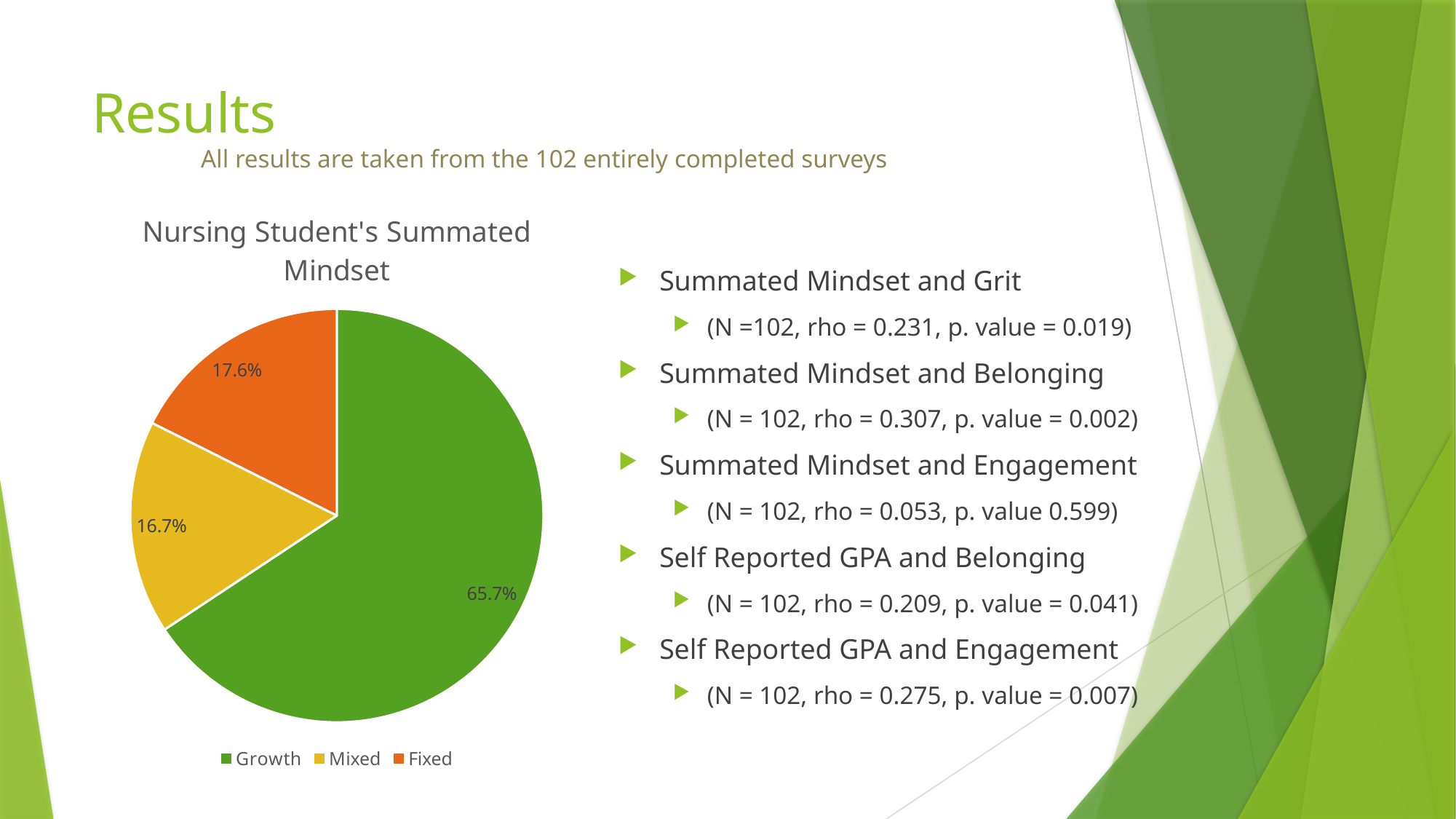
What is the title of the pie chart? Nursing Student's Summated Mindset What percentage of the pie chart is Fixed? 17.6% What percentage of the pie chart is Growth? 65.7% What colour is the Growth slice in the pie chart? green What percentage of the pie chart is Mixed? 16.7% What is the difference in percentage points between the Growth and Fixed slices? 48.1 How many categories does the pie chart show? 3 Which category has the smallest share of the pie chart? Mixed Which category has the largest share of the pie chart? Growth Which slice is larger, Fixed or Mixed? Fixed What kind of chart is shown on the slide? pie chart What is the difference in percentage points between the Fixed and Mixed slices? 0.9